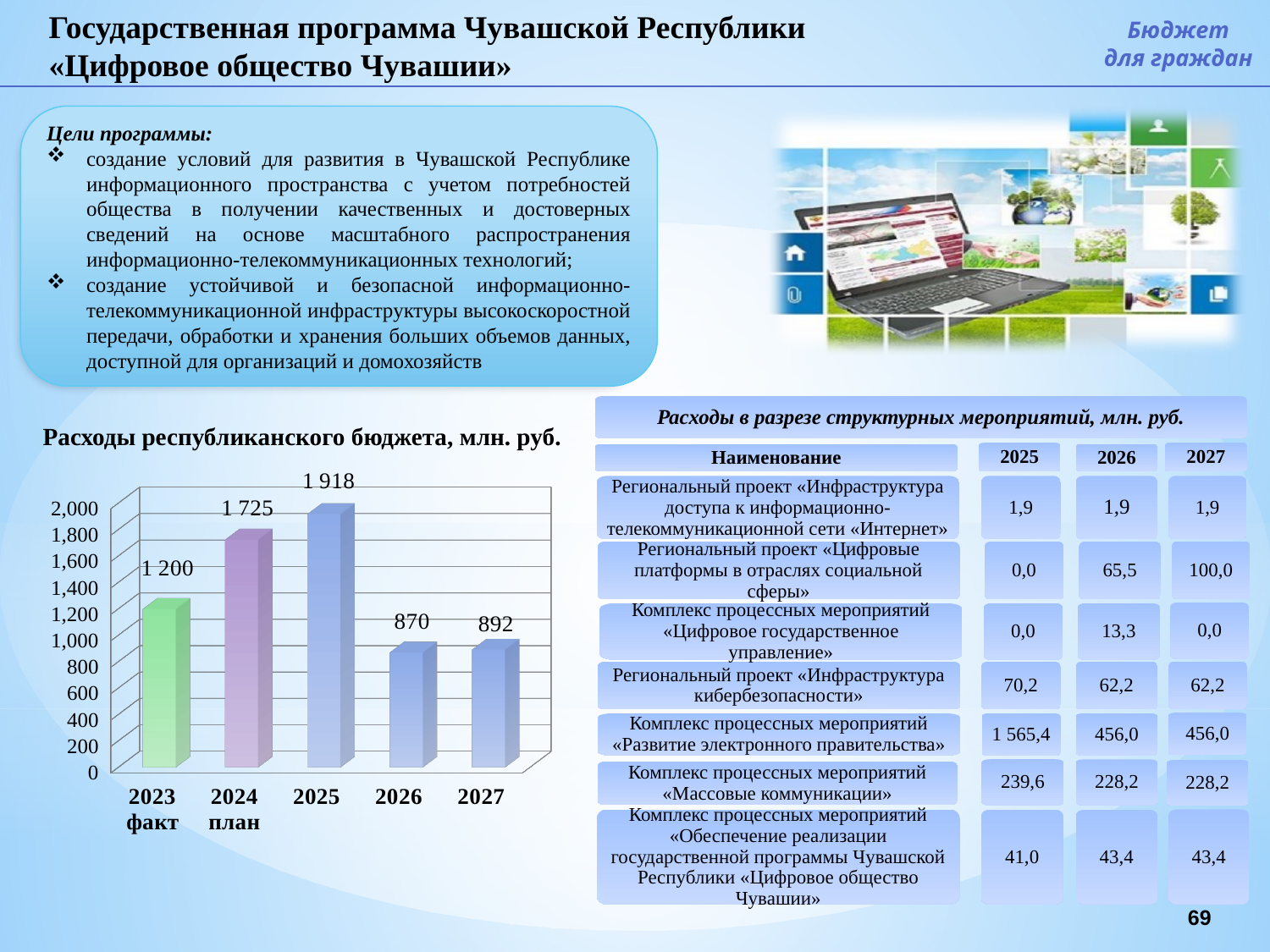
Which year has the lowest value in the chart? 2026 Which is larger, the value for 2024 план or the value for 2023 факт? 2024 план What is the value for 2025 in the chart 'Расходы республиканского бюджета, млн. руб.'? 1 918 What is the difference between the values for 2025 and 2024 план? 193 Is the value for 2026 greater or less than 1,000? less What kind of chart is 'Расходы республиканского бюджета, млн. руб.'? bar chart How many years are shown in the chart? 5 What is the value for 2024 план in the chart? 1 725 What is the difference between the values for 2027 and 2026? 22 Which year has the highest value in the chart? 2025 What is the value for 2023 факт in the chart? 1 200 What is the value for 2027 in the chart? 892